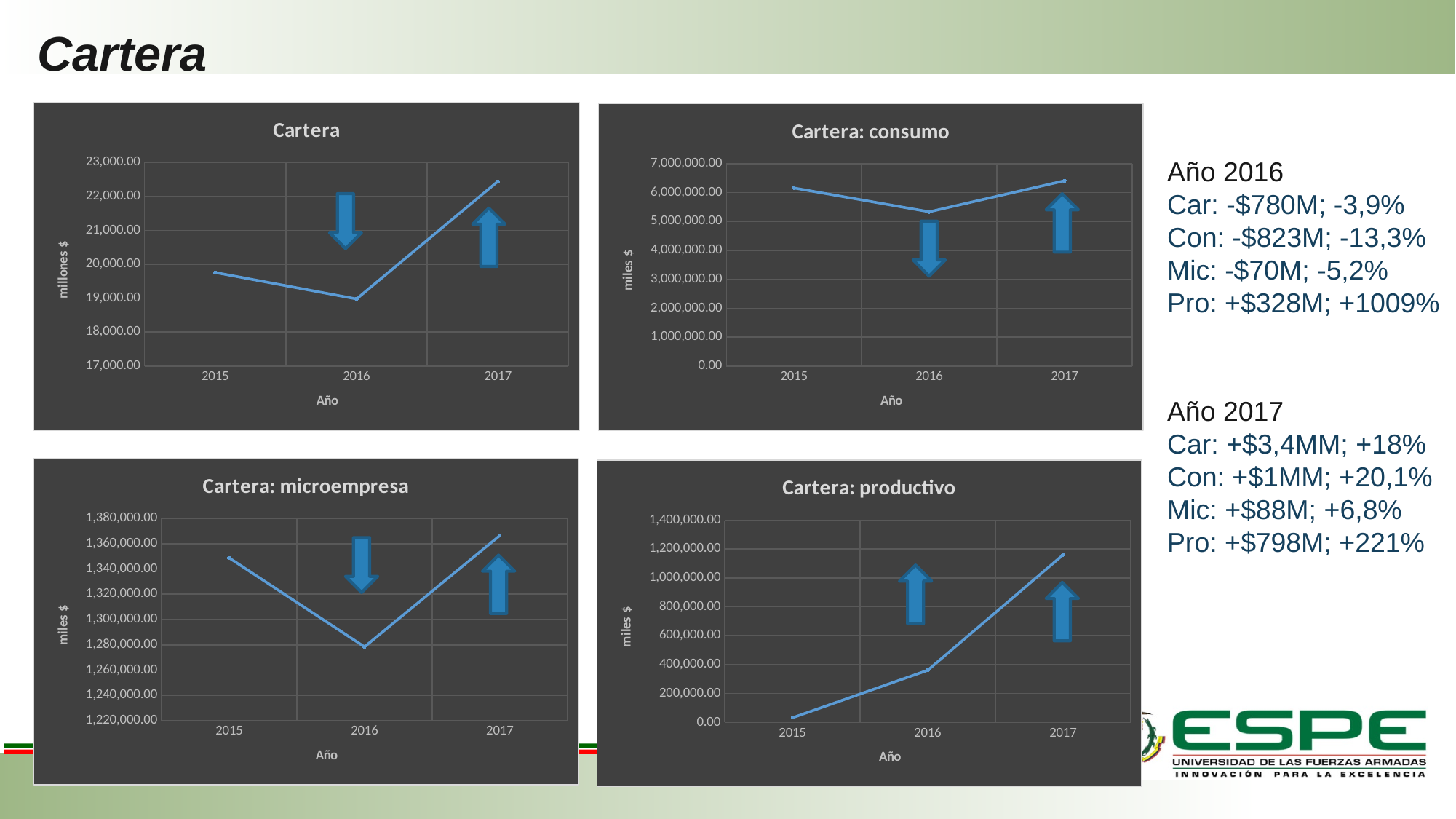
In the "Cartera: productivo" chart, is the value for 2016 greater or less than 400,000.00? less In the "Cartera" chart, which year has the highest value? 2017 In the "Cartera" chart, which year has the lowest value? 2016 How many years are plotted on the x axis of the "Cartera: productivo" chart? 3 In the "Cartera: consumo" chart, is the value for 2017 greater or less than 6,000,000.00? greater In the "Cartera: consumo" chart, which year has the lowest value? 2016 In the "Cartera: microempresa" chart, is the value for 2016 greater or less than 1,300,000.00? less What kind of chart is the "Cartera" chart at the top left? line chart In the "Cartera: productivo" chart, which year has the lowest value? 2015 In the "Cartera: productivo" chart, do the values rise or fall from 2015 to 2017? rise What is the y-axis label of the "Cartera" chart at the top left? millones $